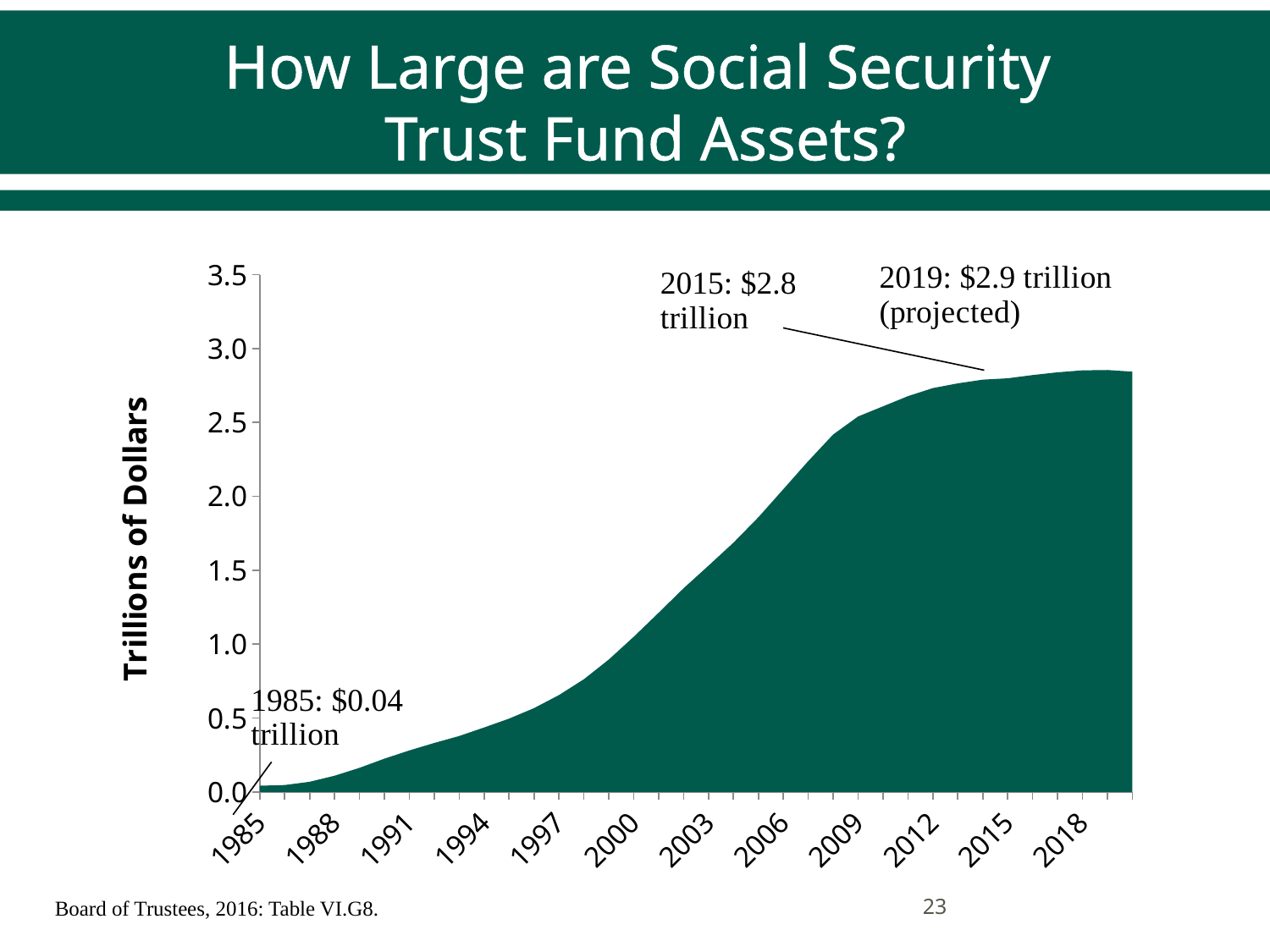
What kind of chart is shown on the slide? Area chart Is the value for 2003 greater or less than 1.0 trillion dollars? greater Is the value for 1991 greater or less than 0.5 trillion dollars? less What is the label on the vertical axis? Trillions of Dollars Do trust fund assets generally rise or fall from 1985 to 2019? Rise Which year has the larger annotated value, 1985 or 2015? 2015 What is the projected value of Social Security Trust Fund assets in 2019? $2.9 trillion What is the value of Social Security Trust Fund assets in 2015 according to the annotation? $2.8 trillion What is the value of Social Security Trust Fund assets in 1985 according to the annotation? $0.04 trillion What is the difference between the annotated values for 2019 and 2015? $0.1 trillion How many year labels are shown on the horizontal axis? 12 Is the value for 2009 greater or less than 2.0 trillion dollars? greater